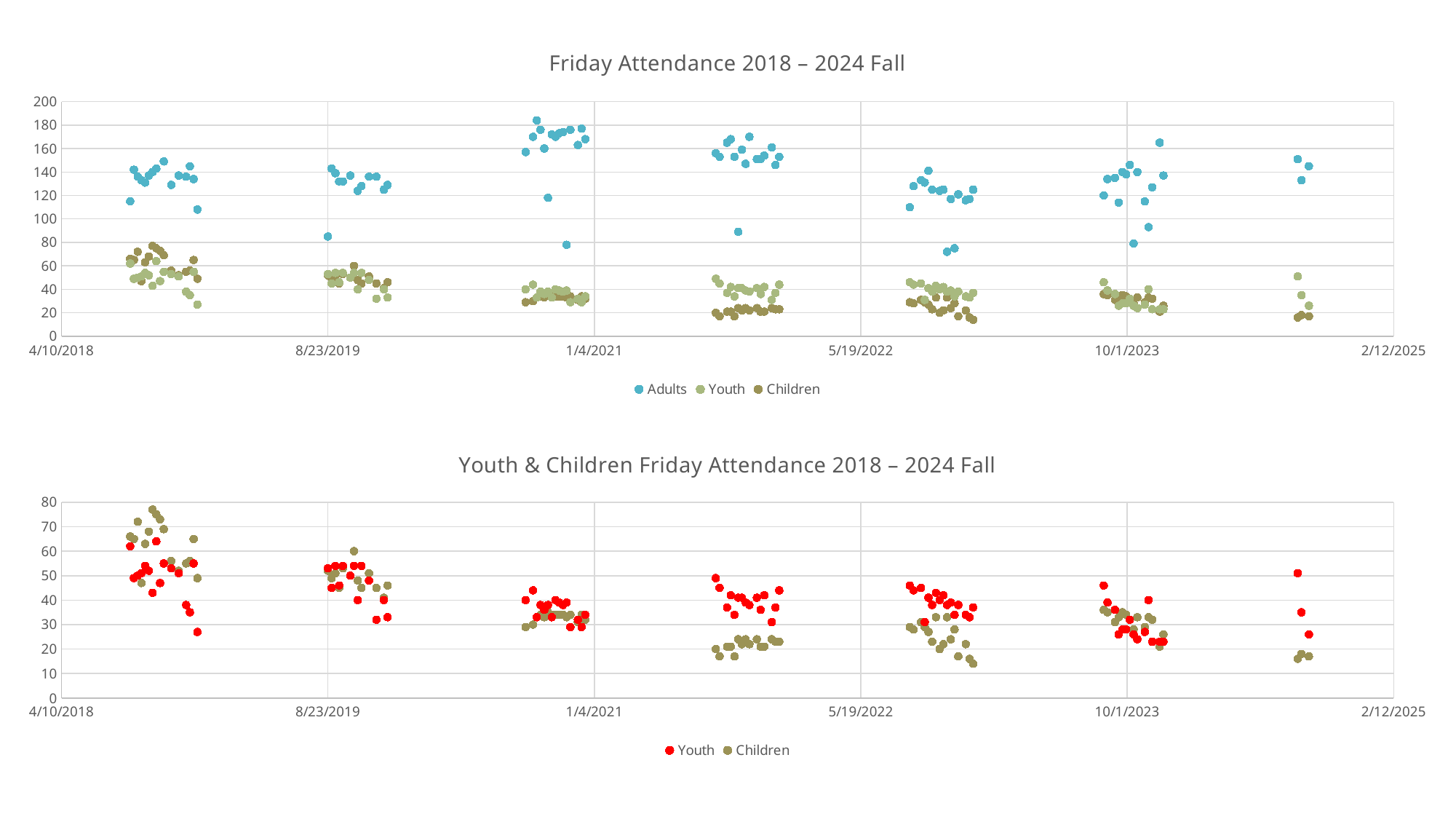
How many series does the legend of the bottom chart, 'Youth & Children Friday Attendance 2018 – 2024 Fall', list? 2 What is the title of the top chart? Friday Attendance 2018 – 2024 Fall In the bottom chart, which series reaches the lowest value? Children In the bottom chart, what colour are the Youth points? red How many series does the legend of the top chart list? 3 In the top chart, which series has the highest values overall? Adults In the top chart, is the lowest Adults value greater or less than 80? less In the bottom chart, is the highest Children value greater or less than 70? greater What kind of chart is the top chart, 'Friday Attendance 2018 – 2024 Fall'? scatter chart In the bottom chart, do the Children values generally rise or fall from 2018 to 2024? fall In the top chart, is the highest Adults value greater or less than 160? greater